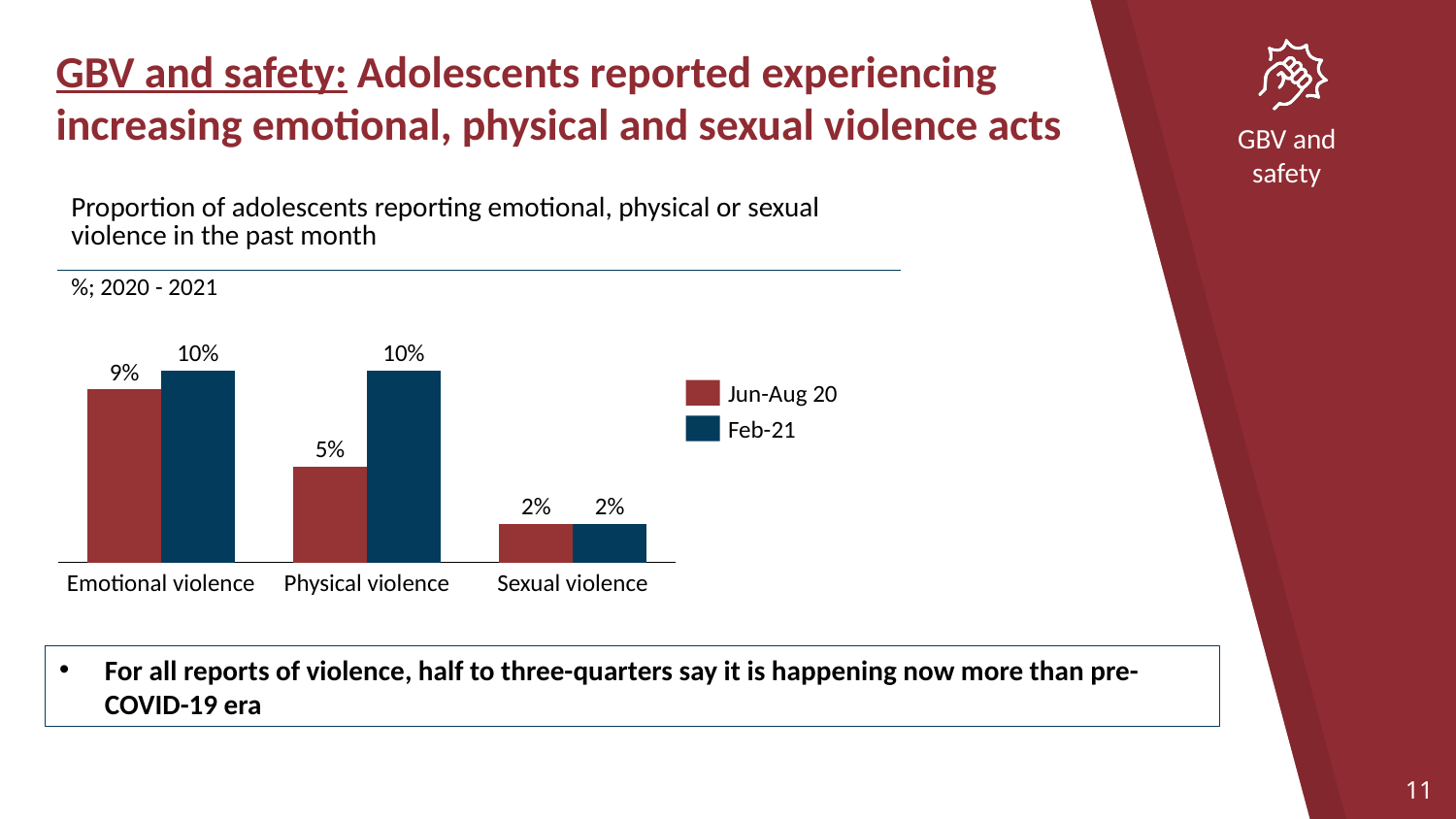
What is the value for Physical violence in the Jun-Aug 20 series? 5% How many series does the legend list? 2 Which is larger for Physical violence: the Jun-Aug 20 value or the Feb-21 value? Feb-21 What are the two series named in the chart legend? Jun-Aug 20 and Feb-21 What kind of chart is shown on the slide? Bar chart Which category has the lowest value in the Feb-21 series? Sexual violence What is the value for Emotional violence in the Jun-Aug 20 series? 9% What is the value for Physical violence in the Feb-21 series? 10% What is the value for Sexual violence in the Jun-Aug 20 series? 2% What is the difference between the Feb-21 and Jun-Aug 20 values for Physical violence? 5% How many categories are shown on the x axis of the chart? 3 Which category has the highest value in the Jun-Aug 20 series? Emotional violence